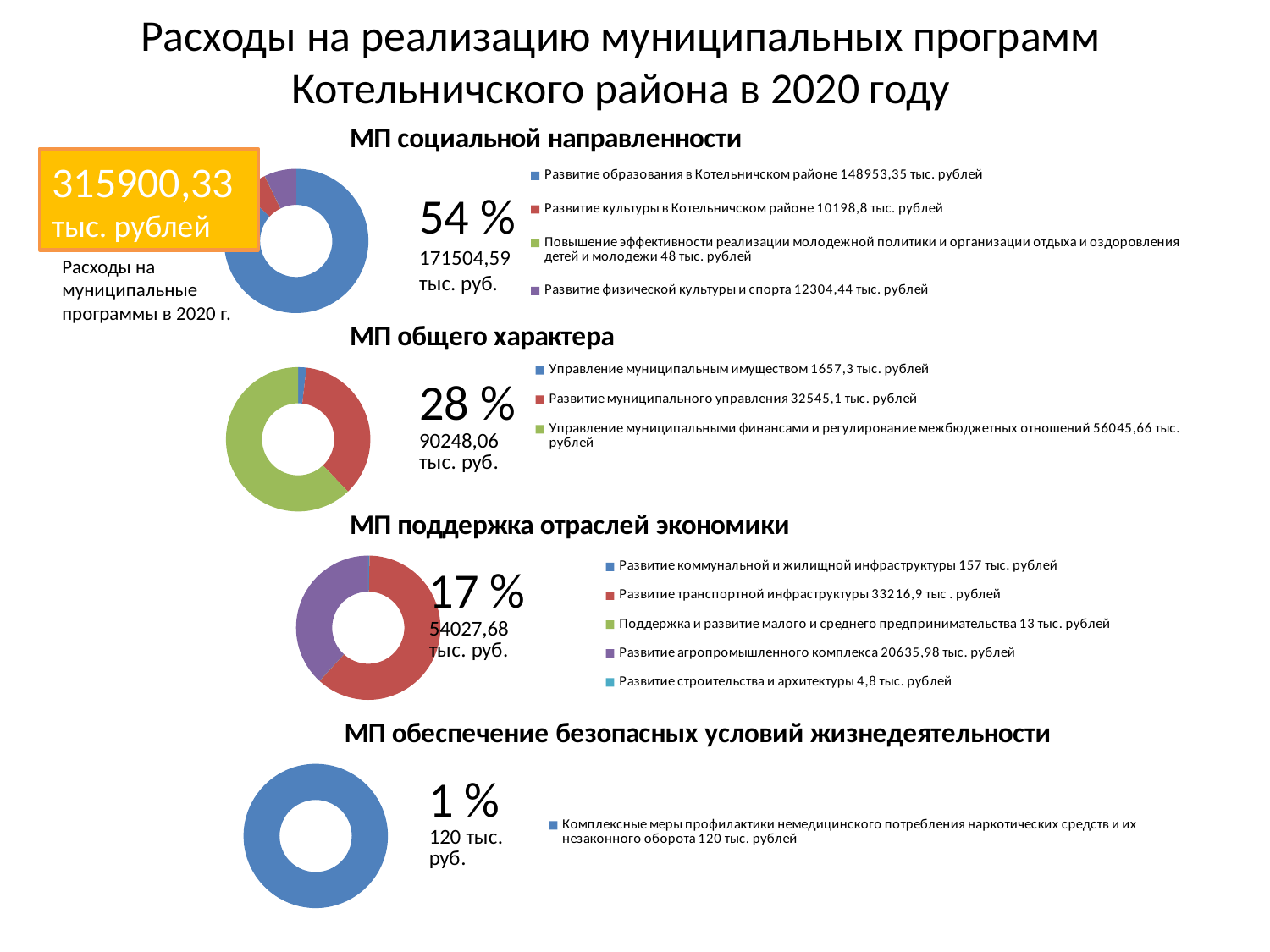
In the chart 'МП общего характера', how many categories does the legend list? 3 In the chart 'МП общего характера', which category has the largest value? Управление муниципальными финансами и регулирование межбюджетных отношений In the chart 'МП социальной направленности', what is the value for 'Развитие образования в Котельничском районе'? 148953,35 тыс. рублей What kind of chart is used for 'МП обеспечение безопасных условий жизнедеятельности'? Doughnut (pie) chart In the chart 'МП общего характера', what is the value for 'Развитие муниципального управления'? 32545,1 тыс. рублей In the chart 'МП социальной направленности', which category has the smallest value? Повышение эффективности реализации молодежной политики и организации отдыха и оздоровления детей и молодежи In the chart 'МП поддержка отраслей экономики', what is the value for 'Развитие агропромышленного комплекса'? 20635,98 тыс. рублей In the chart 'МП поддержка отраслей экономики', how many categories does the legend list? 5 What total amount of spending on municipal programmes in 2020 is shown in the orange box on the slide? 315900,33 тыс. рублей In the chart 'МП социальной направленности', what share of total municipal programme spending does this group represent, as printed on the slide? 54 % In the chart 'МП поддержка отраслей экономики', what is the difference between 'Развитие коммунальной и жилищной инфраструктуры' and 'Поддержка и развитие малого и среднего предпринимательства'? 144 тыс. рублей In the chart 'МП поддержка отраслей экономики', which is larger: 'Развитие транспортной инфраструктуры' or 'Развитие агропромышленного комплекса'? Развитие транспортной инфраструктуры